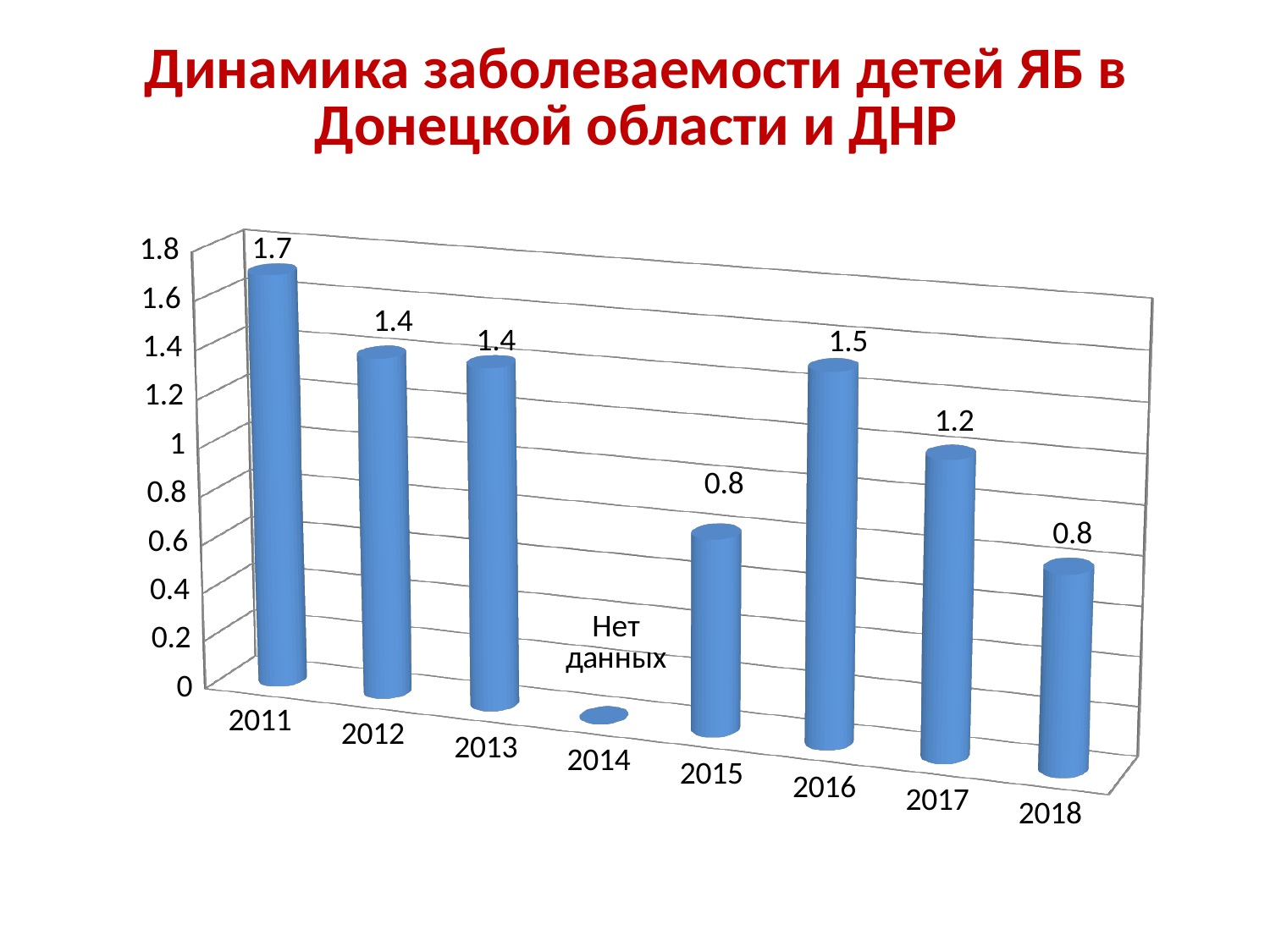
What kind of chart is shown on the slide? bar chart What is the value for 2018? 0.8 What is the difference between the values for 2011 and 2018? 0.9 Is the value for 2013 greater or less than 1? greater Which is larger, the value for 2015 or the value for 2016? 2016 Which year has the highest value? 2011 What is the value for 2017? 1.2 What label is shown for 2014 instead of a value? Нет данных What is the value for 2011? 1.7 How many years are shown on the x axis? 8 What is the value for 2016? 1.5 What is the difference between the values for 2016 and 2017? 0.3